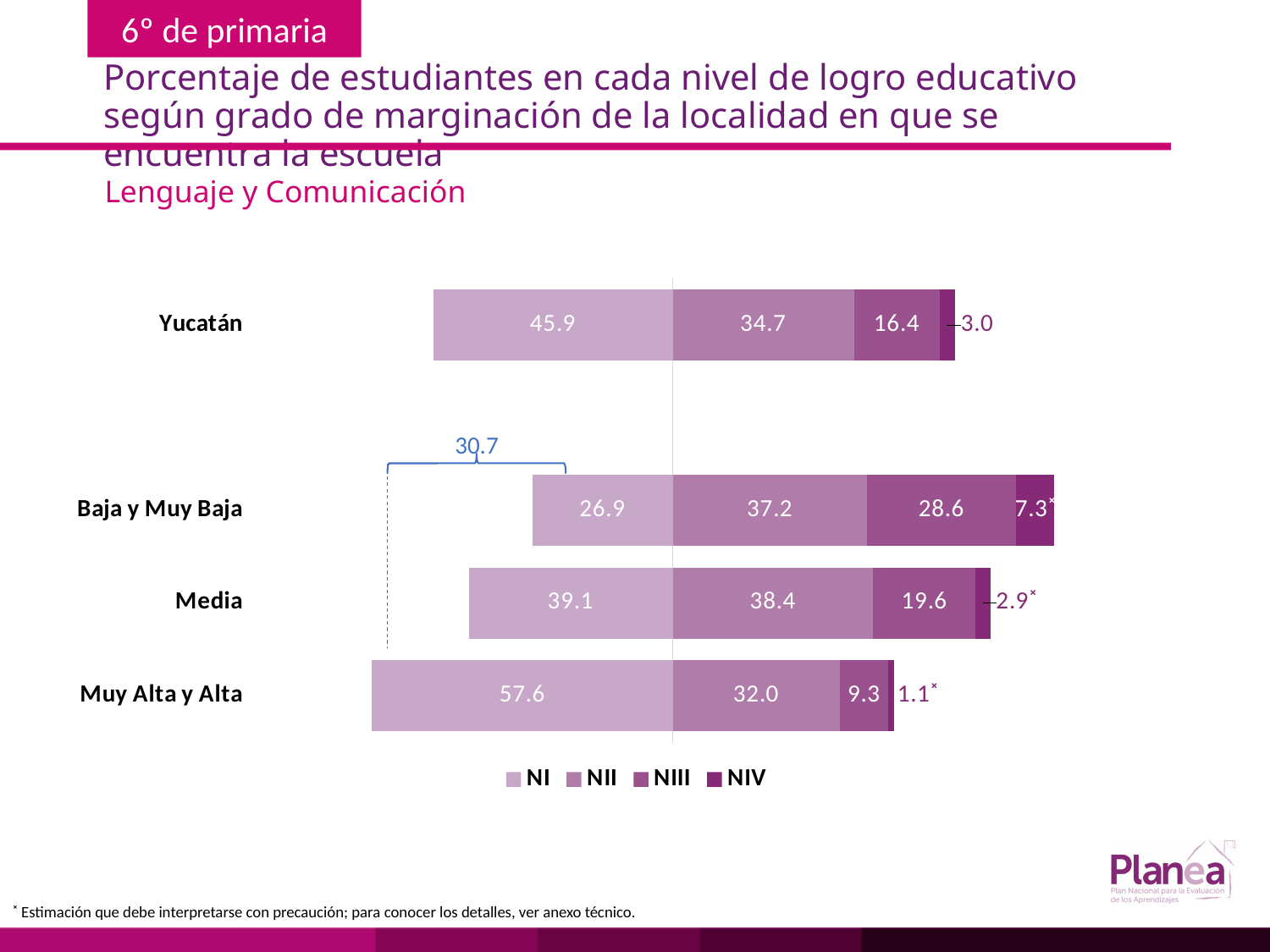
Which is larger, the NII value for Yucatán or the NII value for Media? Media What is the difference between the NI value for Muy Alta y Alta and the NI value for Baja y Muy Baja? 30.7 What is the NIII value for Baja y Muy Baja? 28.6 How many categories are shown on the chart? 4 What kind of chart is shown on the slide? Stacked bar chart Which category has the lowest NIV value? Muy Alta y Alta How many series does the legend list? 4 Which category has the highest NI value? Muy Alta y Alta What is the total of the stacked bar for Yucatán? 100.0 What is the NII value for Media? 38.4 What is the NIV value for Muy Alta y Alta? 1.1 What is the NI value for Yucatán? 45.9